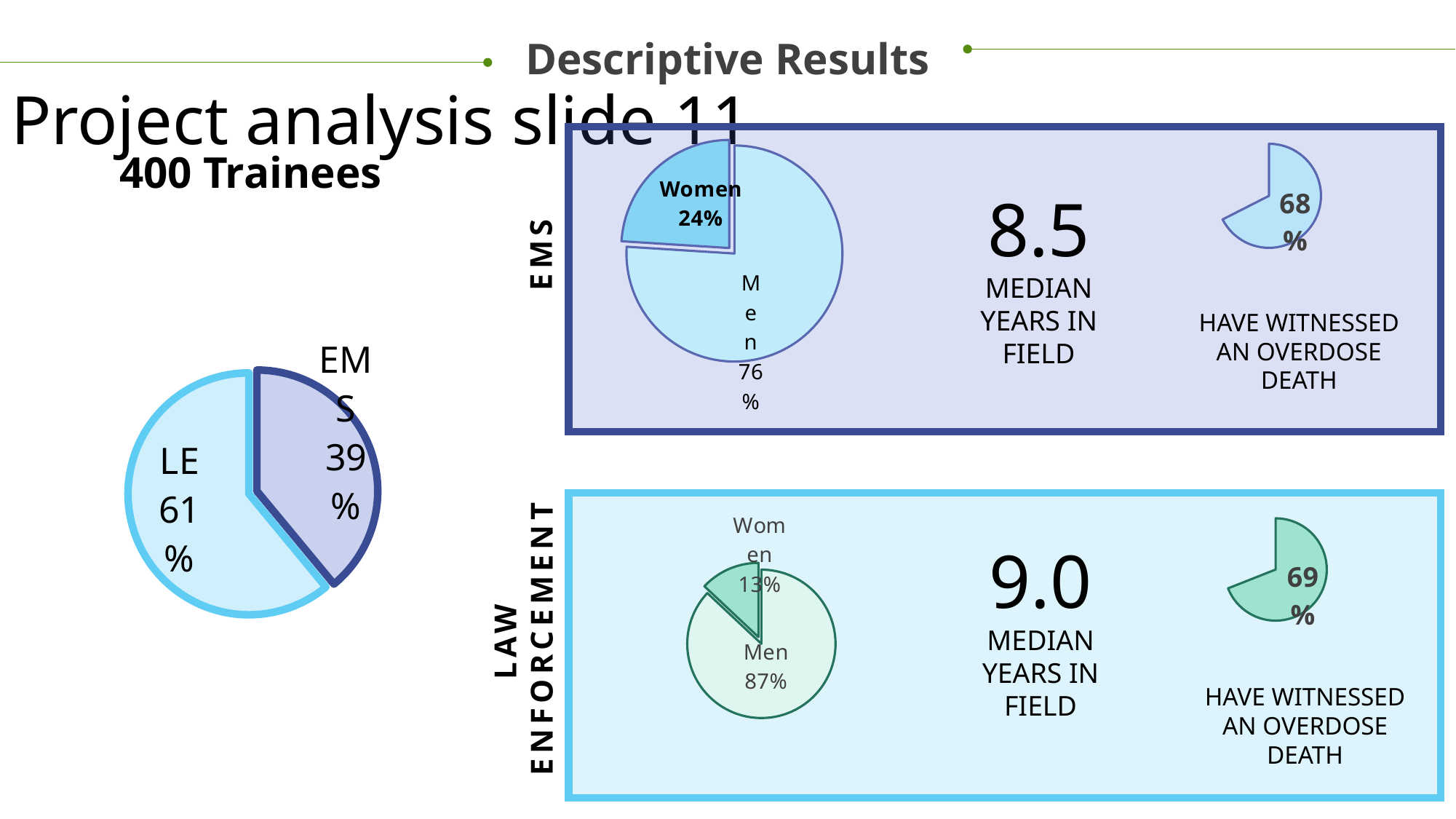
In the EMS gender pie chart, what share is Women? 24% In the 400 Trainees pie chart, what share of trainees is EMS? 39% In the 400 Trainees pie chart, which slice is larger, LE or EMS? LE What kind of chart is the 400 Trainees chart? pie chart In the Law Enforcement gender pie chart, what share is Women? 13% In the 400 Trainees pie chart, what is the difference between the LE and EMS shares? 22% In the Law Enforcement gender pie chart, what is the difference between the Men and Women shares? 74% In the 400 Trainees pie chart, how many slices are there? 2 Which group has a larger share of Women, EMS or Law Enforcement? EMS